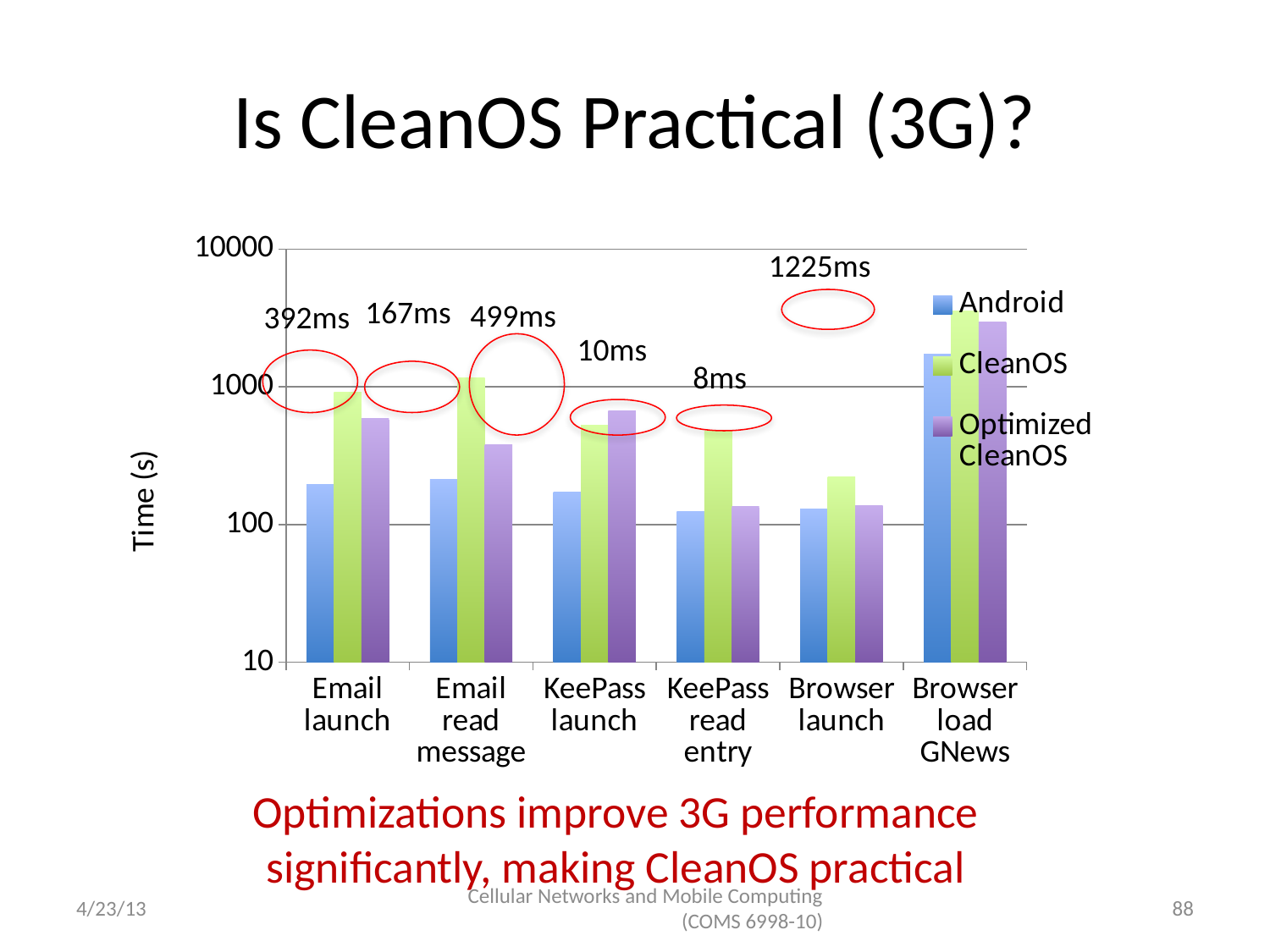
Is the CleanOS value for Email read message greater or less than 1000? greater How many series does the chart's legend list? 3 Is the Android value for Browser load GNews greater or less than 1000? greater How many categories are shown along the x axis of the chart? 6 For KeePass read entry, which is larger: the Android value or the CleanOS value? CleanOS Which category has the highest Android value? Browser load GNews What kind of chart is shown on the slide? bar chart Which category has the lowest CleanOS value? Browser launch Which series are listed in the chart's legend? Android, CleanOS, Optimized CleanOS What is the label on the chart's y axis? Time (s) Is the Android value for Email launch greater or less than 1000? less For Email launch, which is larger: the CleanOS value or the Optimized CleanOS value? CleanOS